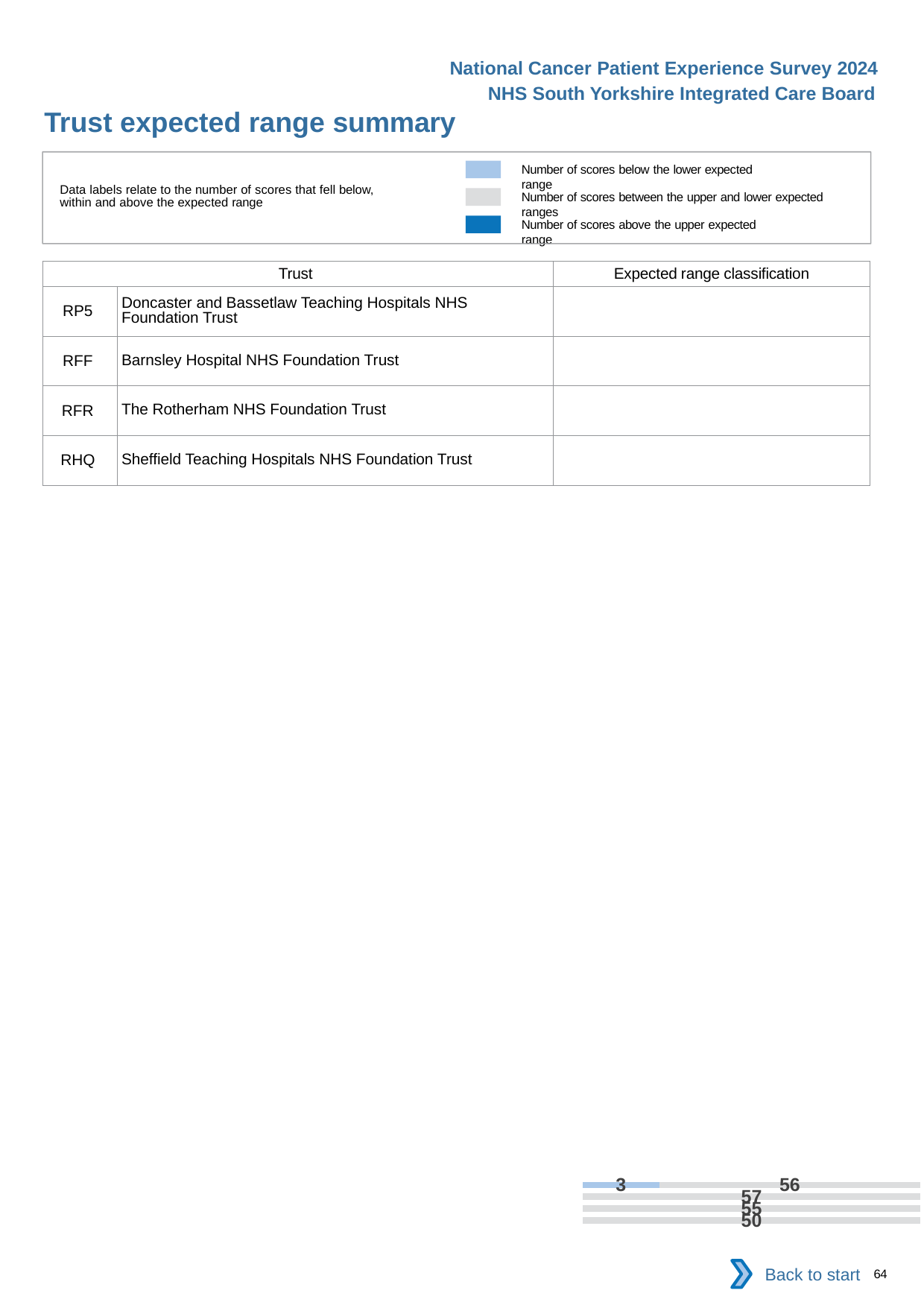
In the chart at the bottom of the slide, what is the total of the top bar (3 plus 56)? 59 In the chart at the bottom of the slide, which segment of the top bar is larger, the light blue one or the grey one? the grey one What kind of chart is shown at the bottom of the slide? bar chart According to the legend, what does the light blue colour represent? Number of scores below the lower expected range How many series does the legend at the top of the slide list for the chart? 3 According to the legend, what does the dark blue colour represent? Number of scores above the upper expected range In the chart at the bottom of the slide, what is the value of the grey segment in the top bar? 56 In the chart at the bottom of the slide, what is the value of the light blue segment in the top bar? 3